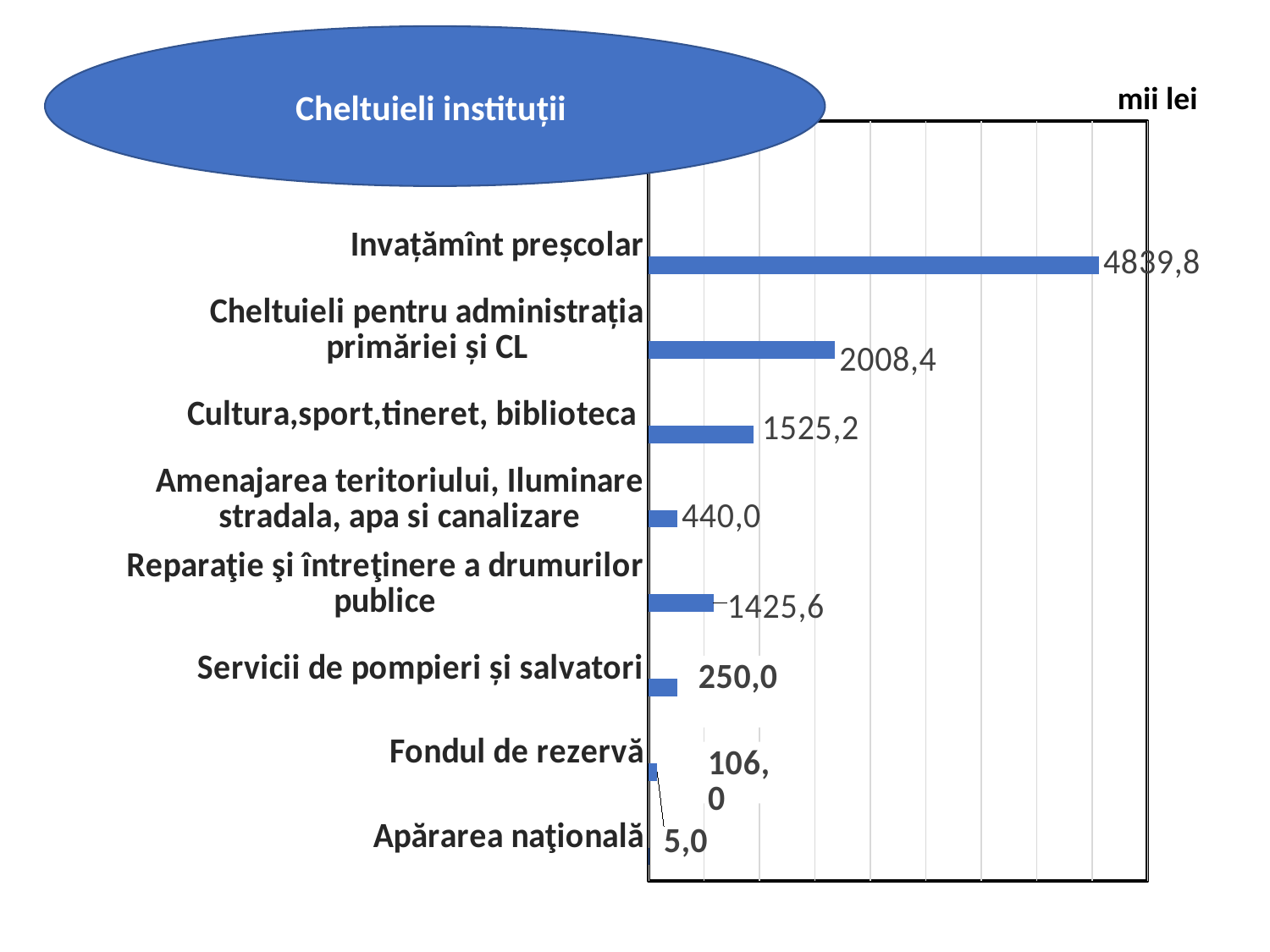
What is the value for Cheltuieli pentru administrația primăriei și CL? 2008,4 What is the difference between the values for Servicii de pompieri și salvatori and Fondul de rezervă? 144,0 Which category has the lowest value? Apărarea naţională What kind of chart is shown on the slide? Bar chart How many categories are shown in the chart? 8 What is the value for Fondul de rezervă? 106,0 What is the value for Cultura,sport,tineret, biblioteca? 1525,2 What is the difference between the values for Invațămînt preșcolar and Cheltuieli pentru administrația primăriei și CL? 2831,4 What is the value for Servicii de pompieri și salvatori? 250,0 What is the value for Invațămînt preșcolar? 4839,8 Which category has the highest value? Invațămînt preșcolar Which is larger, the value for Cultura,sport,tineret, biblioteca or the value for Servicii de pompieri și salvatori? Cultura,sport,tineret, biblioteca